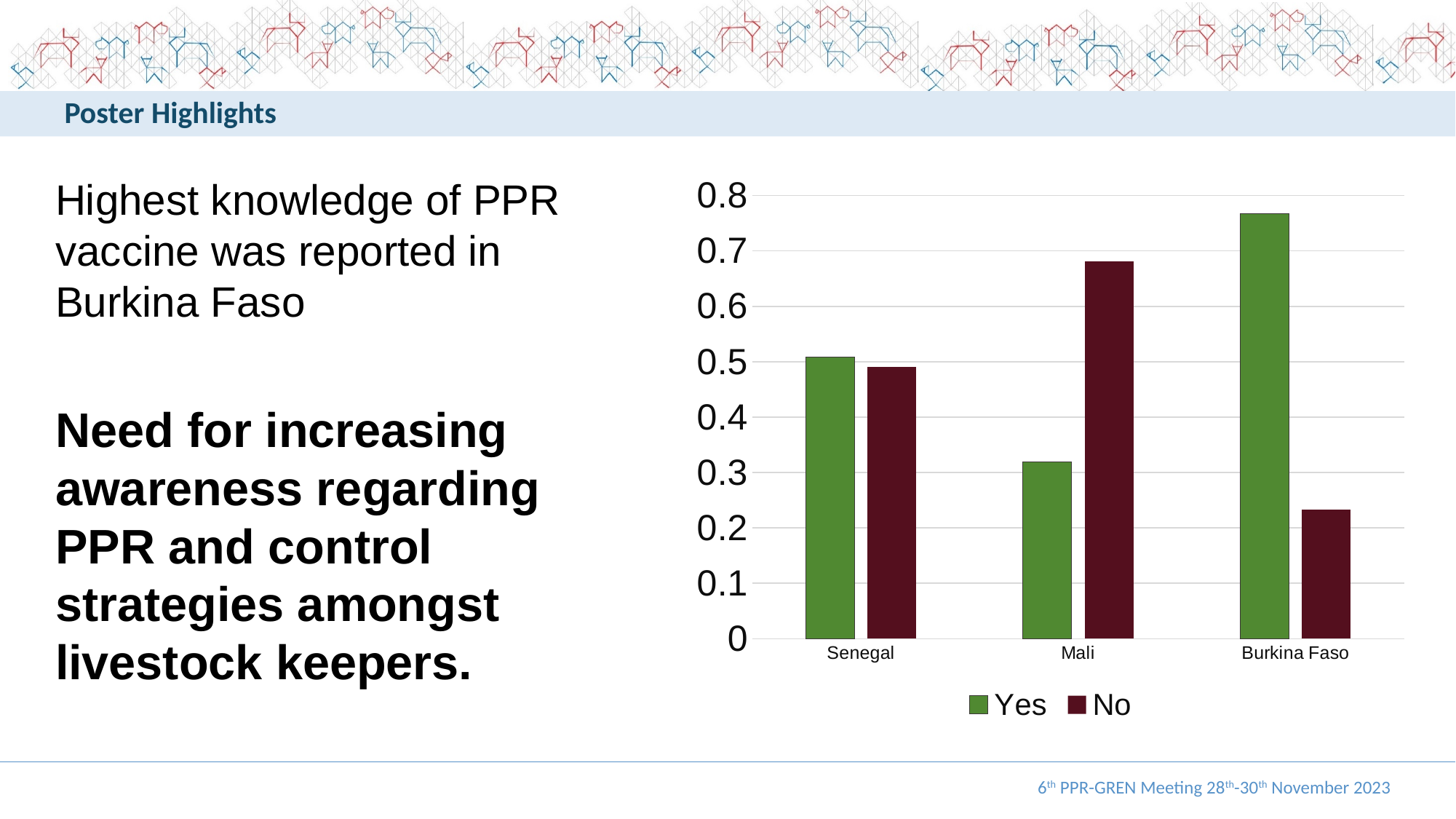
Is the 'No' value for Mali greater or less than 0.6? greater Which country has the lowest 'Yes' bar? Mali Which country has the highest 'No' bar? Mali Which country has the highest 'Yes' bar? Burkina Faso For Mali, which is larger, the 'Yes' bar or the 'No' bar? No Is the 'No' value for Burkina Faso greater or less than 0.3? less What are the two series named in the chart's legend? Yes and No How many countries are shown on the x axis of the chart? 3 Is the 'Yes' value for Burkina Faso greater or less than 0.7? greater What kind of chart is shown on the slide? bar chart How many series does the chart's legend list? 2 Which country has the lowest 'No' bar? Burkina Faso